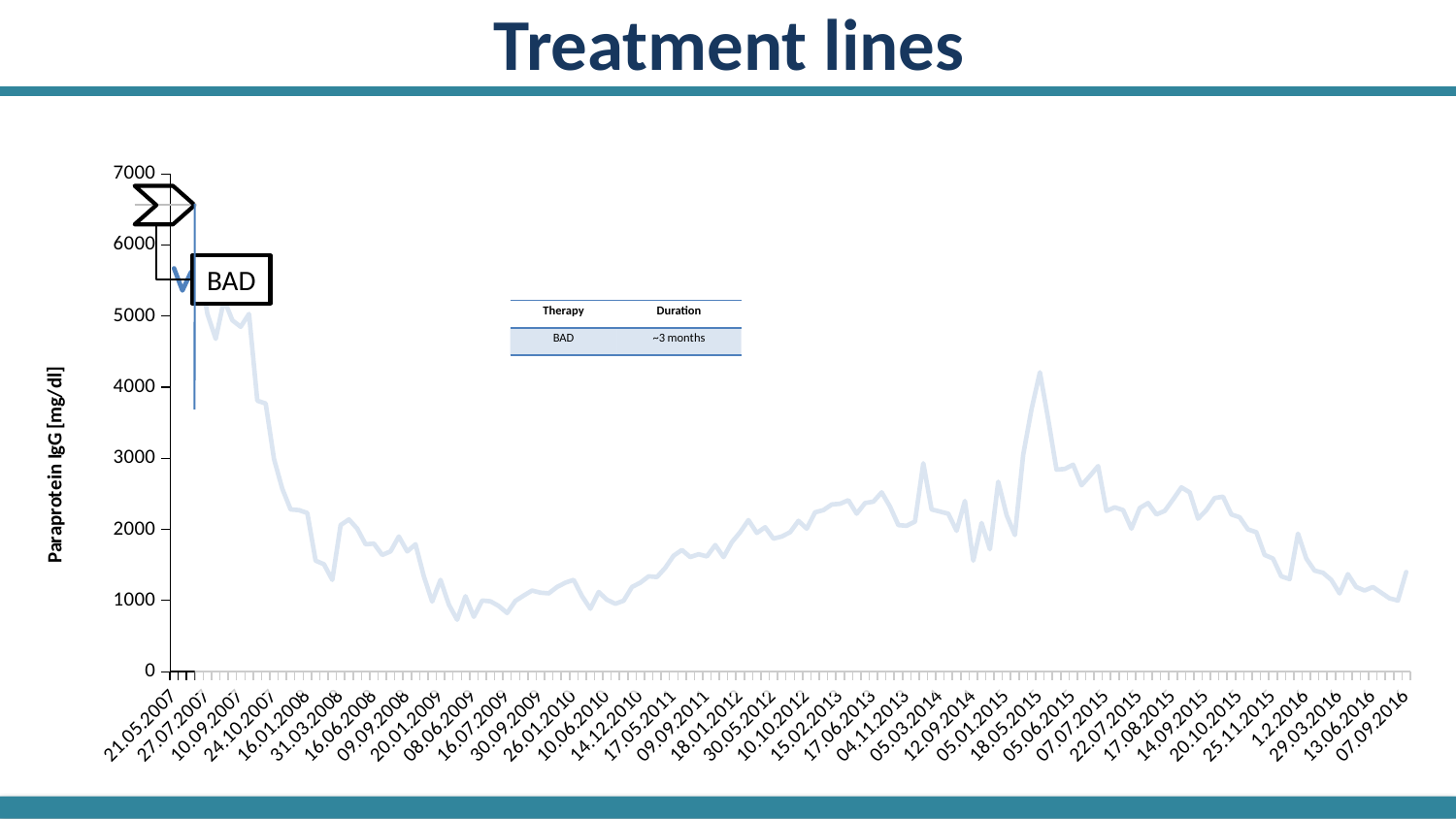
Which is larger, the value around 18.05.2015 or the value at 07.09.2016? 18.05.2015 What kind of chart is shown on the slide? line chart According to the table on the slide, what is the duration of the BAD therapy? ~3 months Is the peak value around 18.05.2015 greater or less than 3000? greater Do the values rise or fall between 10.06.2010 and 15.02.2013? rise Is the value for 16.01.2008 greater or less than 3000? less What is the label of the y axis? Paraprotein IgG [mg/dl] Overall, do the values rise or fall from 21.05.2007 to 07.09.2016? fall Which is larger, the value at 27.07.2007 or the value at 16.07.2009? 27.07.2007 Is the value for 16.07.2009 greater or less than 2000? less